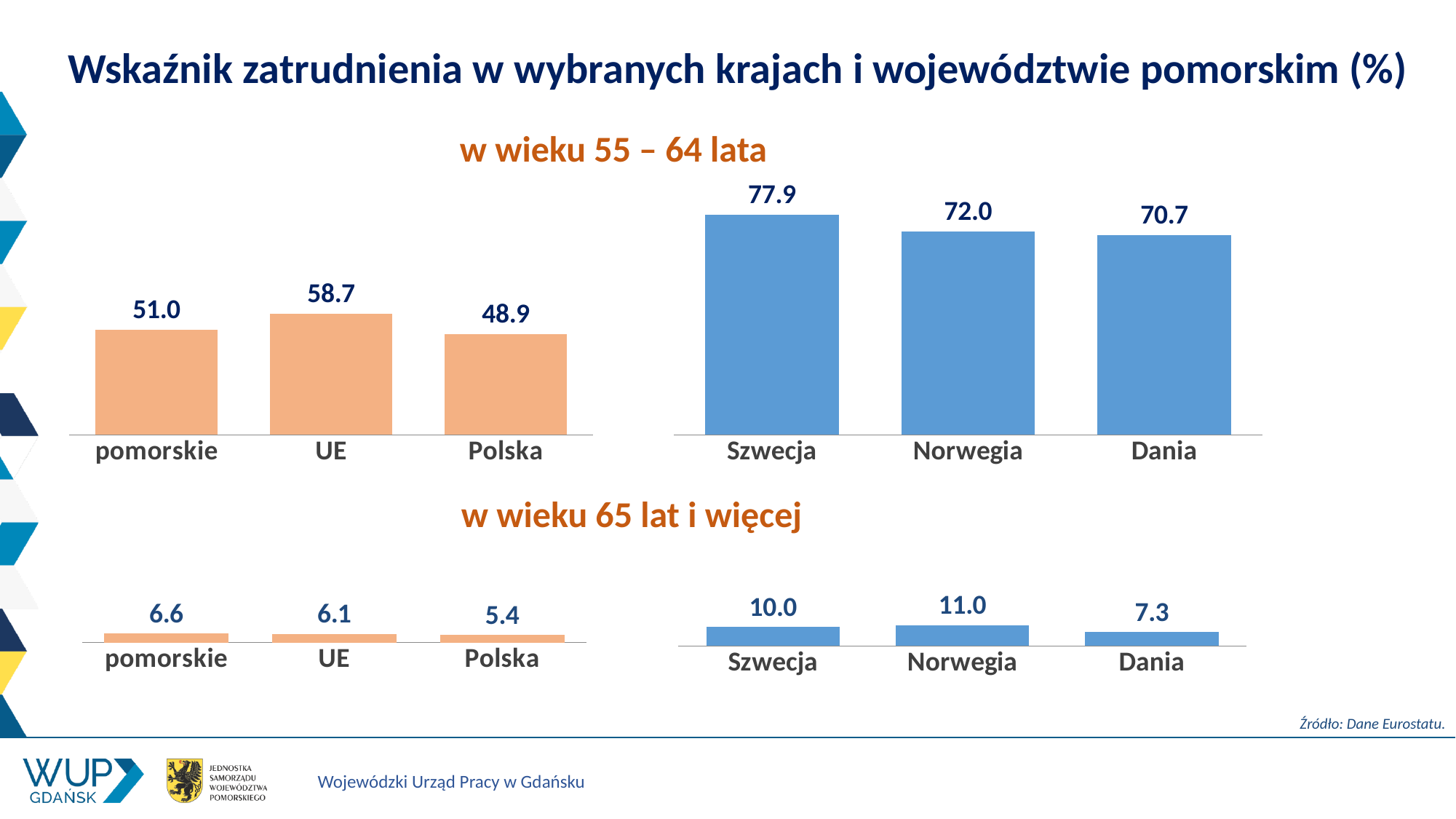
In the 'w wieku 65 lat i więcej' chart, what is the value for Norwegia? 11.0 In the 'w wieku 55 – 64 lata' chart, which is larger, the value for Norwegia or the value for Dania? Norwegia In the 'w wieku 55 – 64 lata' chart, what is the value for pomorskie? 51.0 In the 'w wieku 65 lat i więcej' chart, which category has the highest value? Norwegia In the 'w wieku 55 – 64 lata' chart, what is the value for Szwecja? 77.9 How many categories are shown in the 'w wieku 65 lat i więcej' chart in total? 6 In the 'w wieku 55 – 64 lata' chart, what is the difference between the values for UE and Polska? 9.8 In the 'w wieku 55 – 64 lata' chart, which category has the lowest value? Polska In the 'w wieku 65 lat i więcej' chart, what is the value for Polska? 5.4 In the 'w wieku 65 lat i więcej' chart, what is the difference between the values for Szwecja and Dania? 2.7 In the 'w wieku 55 – 64 lata' chart, which category has the highest value? Szwecja What type of chart is used on this slide? Bar chart